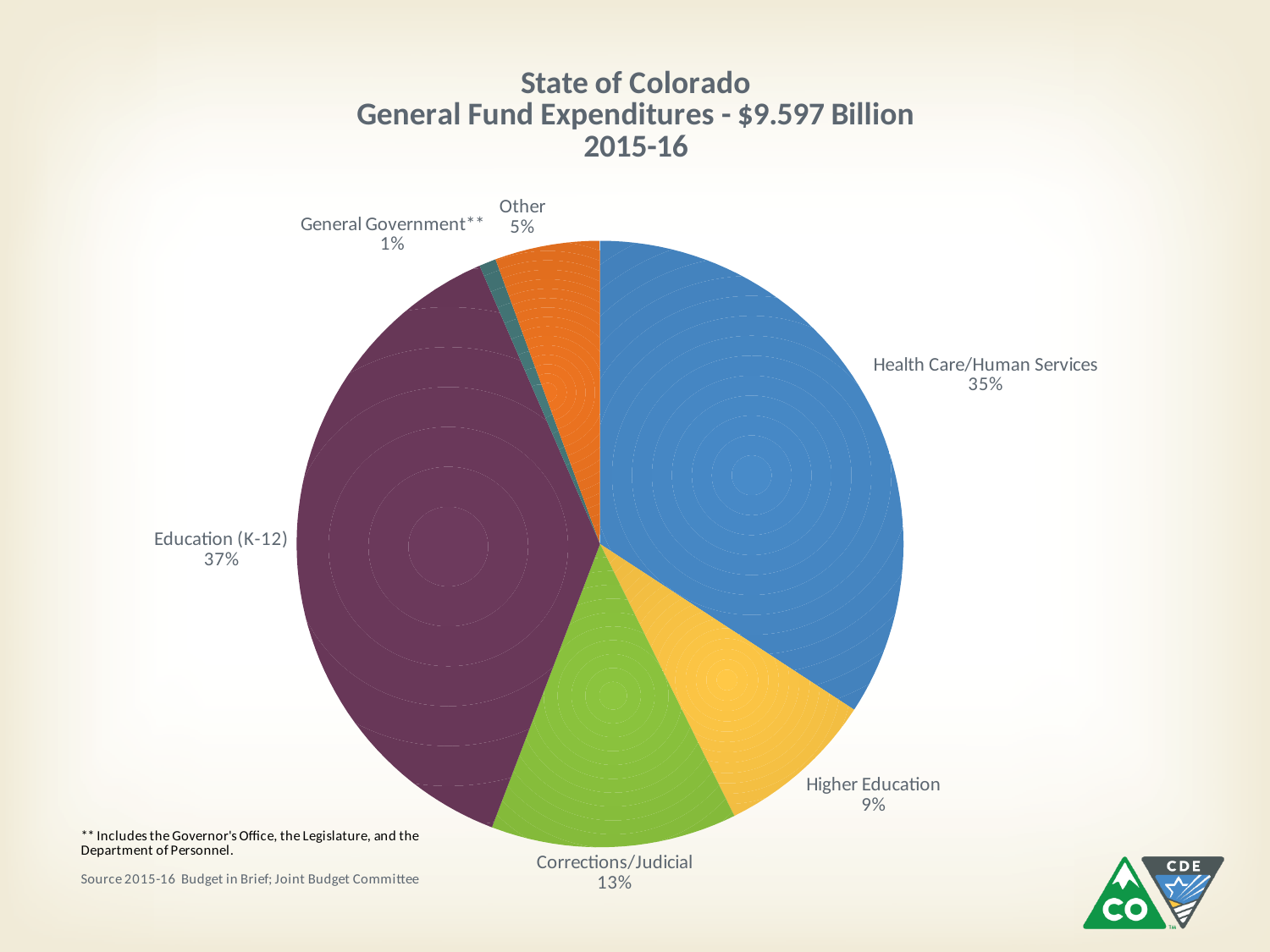
Which category has the largest share of the pie? Education (K-12) What is the difference in percentage points between Education (K-12) and Health Care/Human Services? 2 What share of General Fund Expenditures goes to Education (K-12)? 37% What percentage is shown for Higher Education? 9% Which is larger, the share for Corrections/Judicial or the share for Higher Education? Corrections/Judicial What kind of chart is shown on the slide? pie chart What total dollar amount of General Fund Expenditures is given in the chart title? $9.597 Billion What share of General Fund Expenditures goes to Health Care/Human Services? 35% Which category has the smallest share of the pie? General Government** How many slices does the pie chart have? 6 What percentage is shown for Corrections/Judicial? 13% What percentage is shown for General Government**? 1%